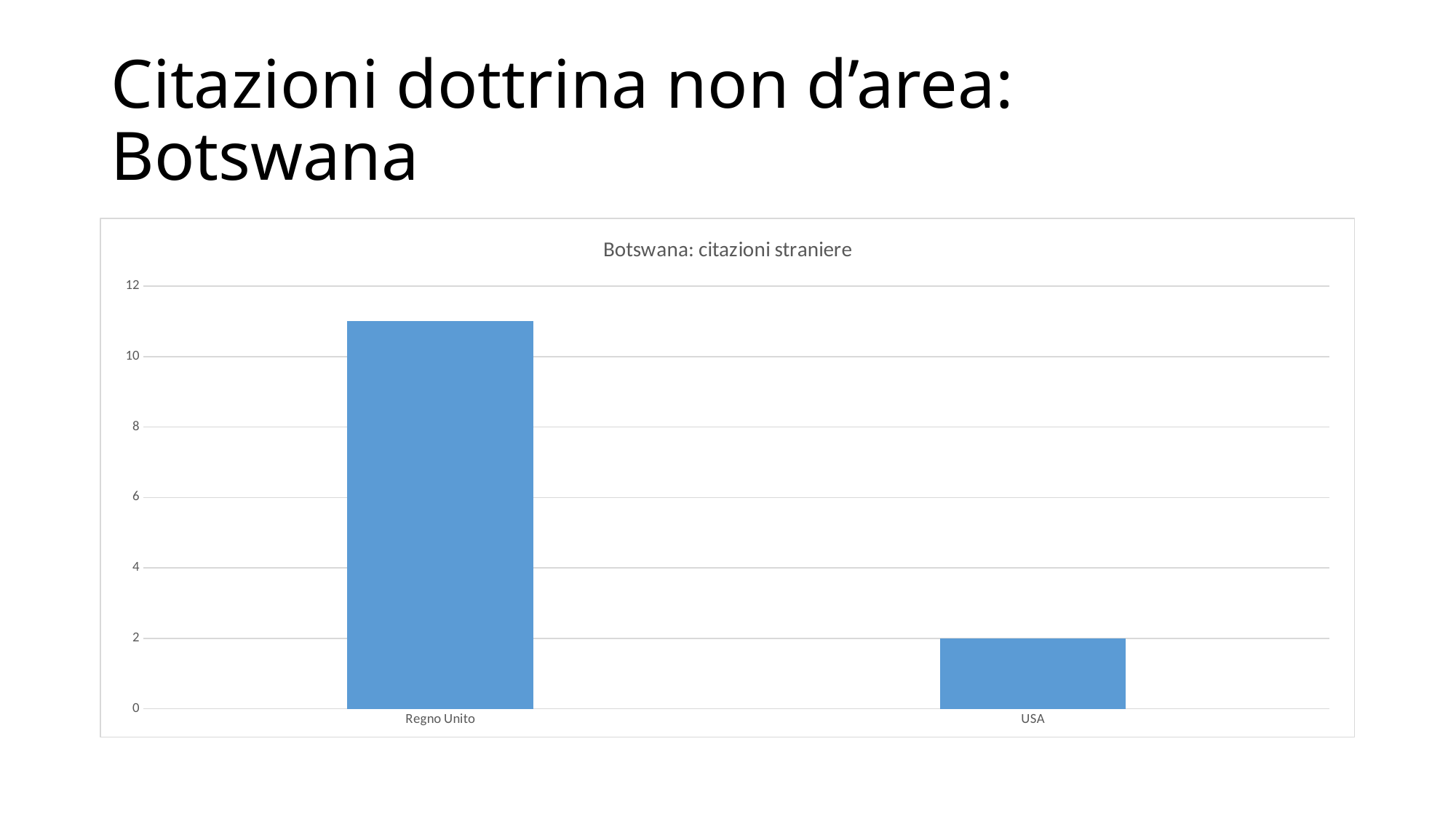
Which category has the highest value? Regno Unito Is the value for USA greater or less than 4? less What is the title of the chart? Botswana: citazioni straniere Which is larger, the value for Regno Unito or the value for USA? Regno Unito Is the value for Regno Unito greater or less than 10? greater What is the value for USA? 2 How many categories are plotted in the chart? 2 What colour are the bars in the chart? blue Is the value for Regno Unito greater or less than 12? less Which category has the lowest value? USA What kind of chart is shown on the slide? bar chart